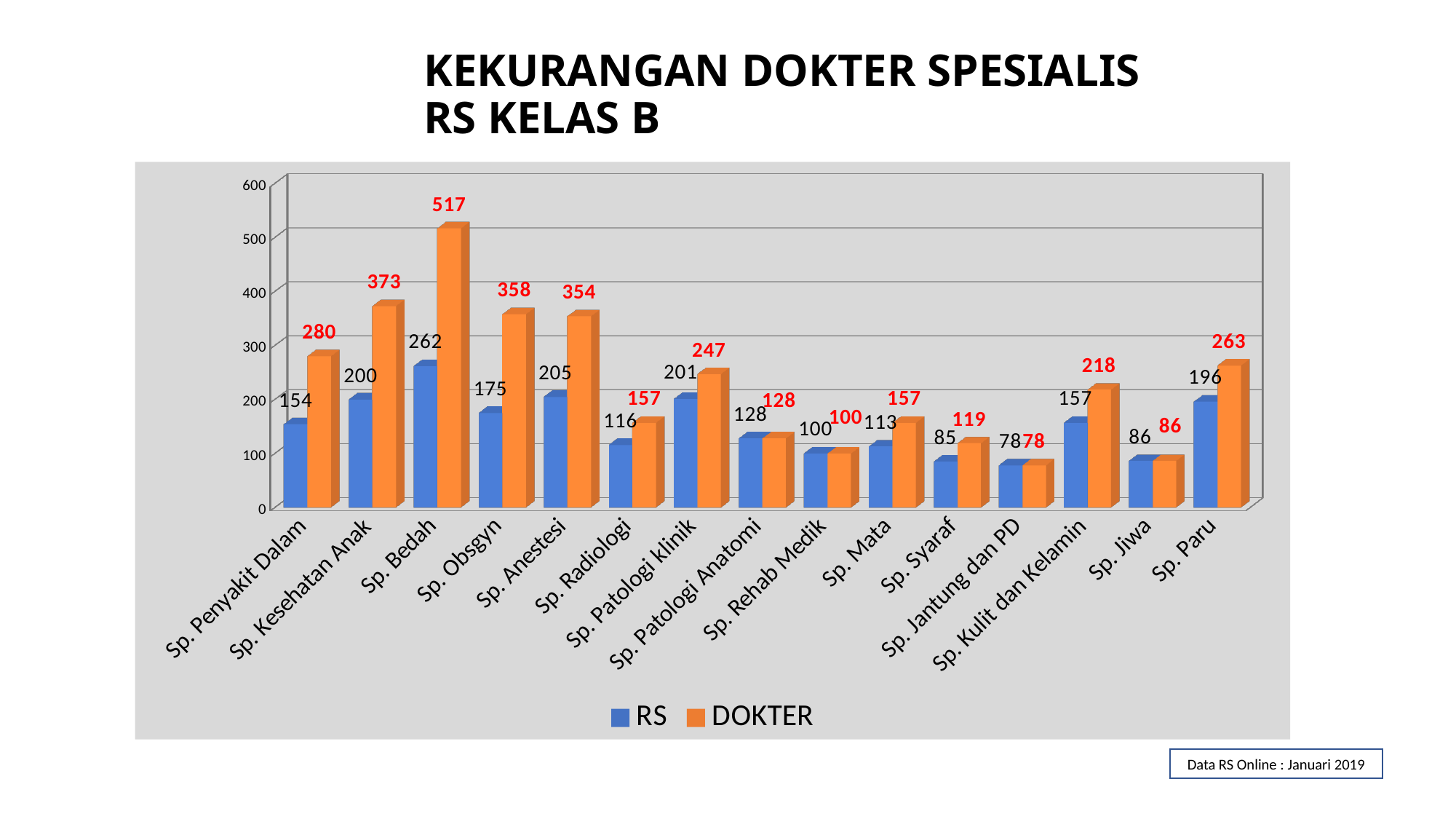
Which category has the highest DOKTER value? Sp. Bedah What kind of chart is shown on the slide? Bar chart What is the difference between the DOKTER values for Sp. Obsgyn and Sp. Anestesi? 4 How many categories are shown on the x axis? 15 What is the DOKTER value for Sp. Bedah? 517 Which is larger, the RS value for Sp. Patologi klinik or the RS value for Sp. Paru? Sp. Patologi klinik What is the DOKTER value for Sp. Kulit dan Kelamin? 218 How many series does the legend list? 2 What is the title of the slide? KEKURANGAN DOKTER SPESIALIS RS KELAS B What is the difference between the DOKTER and RS values for Sp. Penyakit Dalam? 126 Which category has the lowest RS value? Sp. Jantung dan PD What is the RS value for Sp. Kesehatan Anak? 200